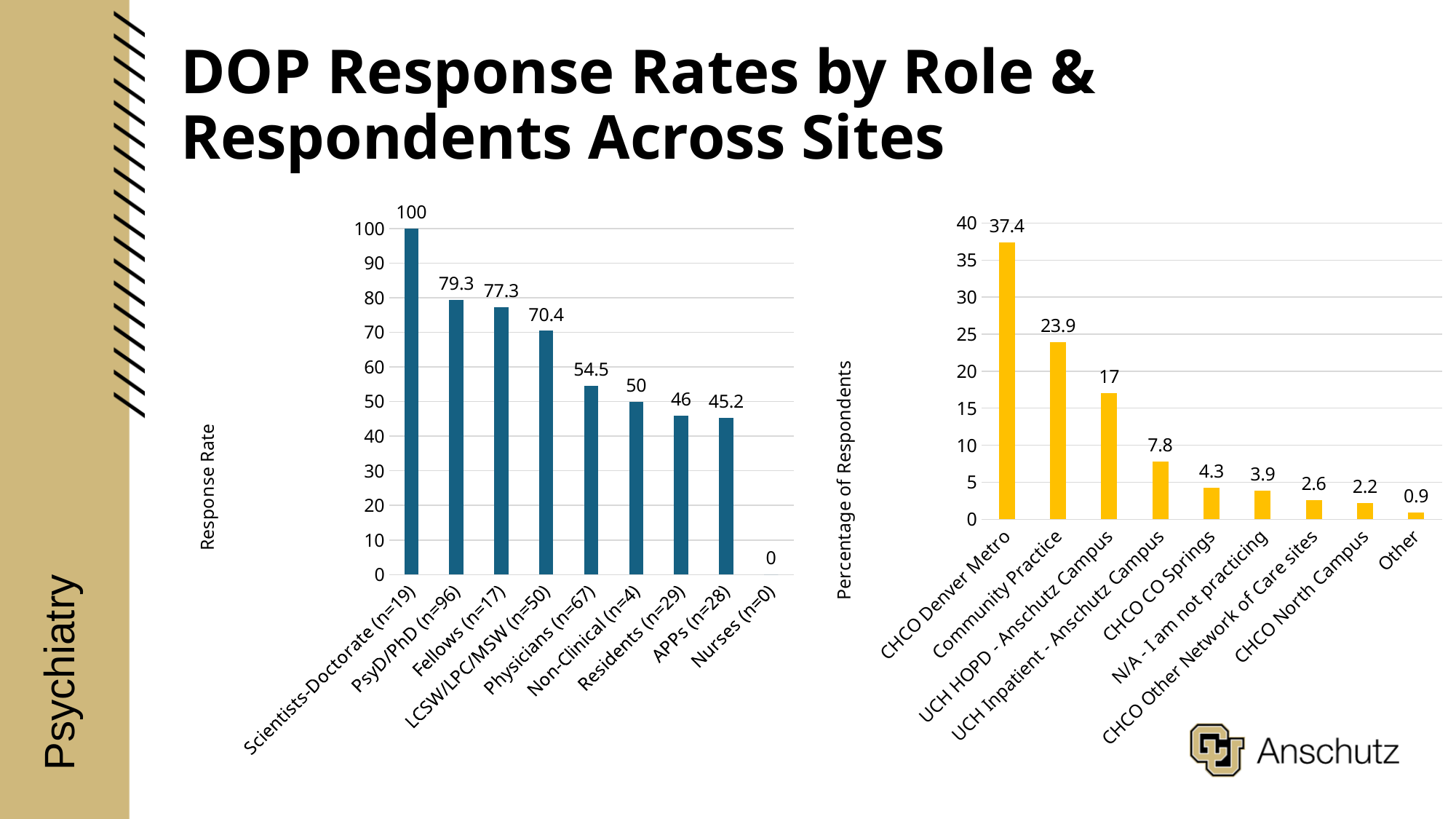
In the left chart (Response Rate), what is the response rate for Physicians (n=67)? 54.5 What kind of chart is the right chart (Percentage of Respondents)? bar chart In the right chart (Percentage of Respondents), which is larger: CHCO CO Springs or UCH Inpatient - Anschutz Campus? UCH Inpatient - Anschutz Campus In the right chart (Percentage of Respondents), which category has the lowest value? Other In the left chart (Response Rate), do the values rise or fall from left to right along the x axis? fall In the left chart (Response Rate), which role has the lowest response rate? Nurses (n=0) In the right chart (Percentage of Respondents), how many categories are shown on the x axis? 9 In the left chart (Response Rate), which role has the highest response rate? Scientists-Doctorate (n=19) In the right chart (Percentage of Respondents), what is the value for Community Practice? 23.9 In the left chart (Response Rate), what is the difference between the response rates of PsyD/PhD (n=96) and Fellows (n=17)? 2 In the left chart (Response Rate), how many roles are shown on the x axis? 9 In the right chart (Percentage of Respondents), which site has the highest percentage of respondents? CHCO Denver Metro